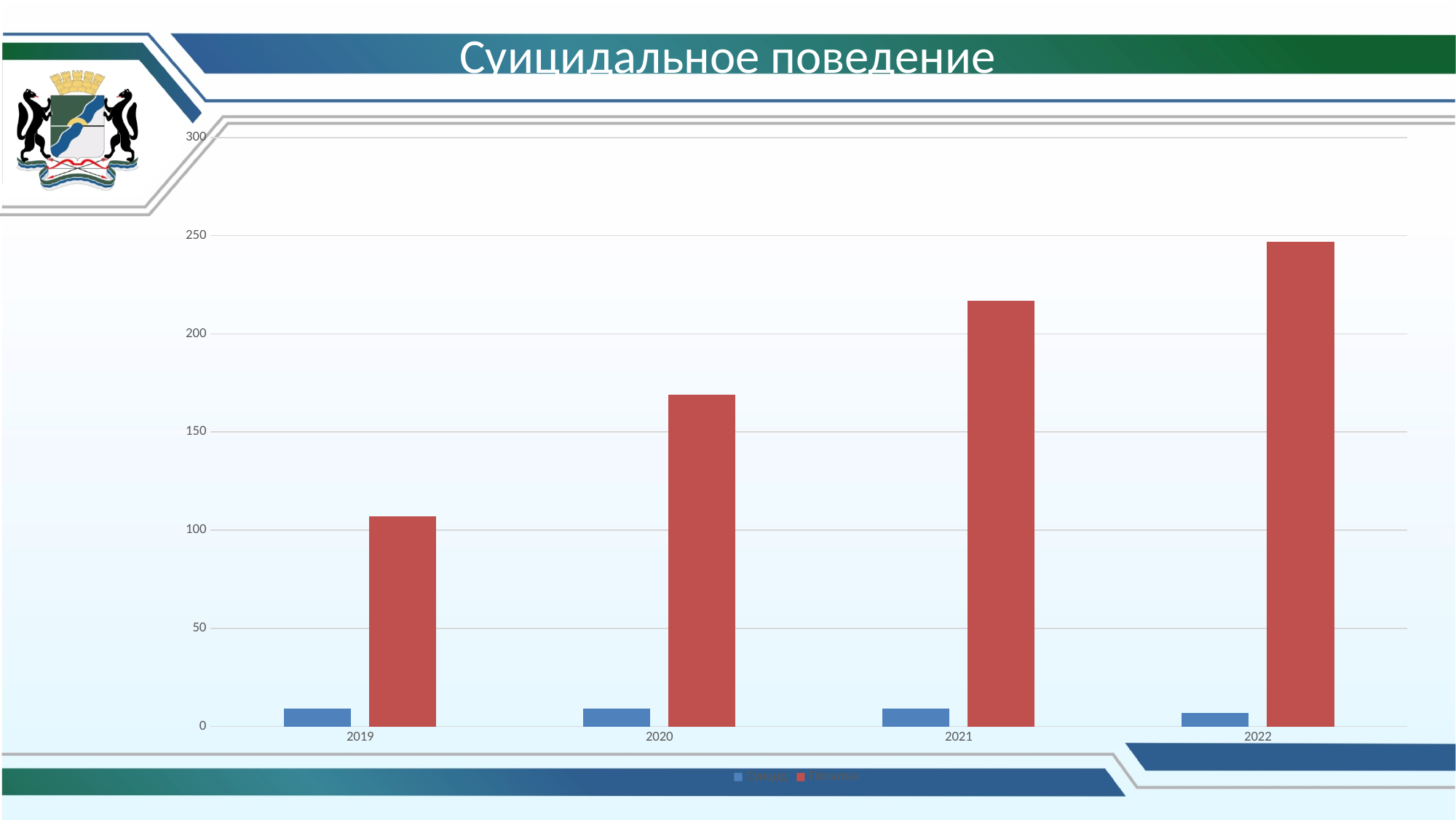
How many years are shown on the x axis of the chart? 4 Is the value of the red bar for 2021 greater or less than 200? greater Is the value of the red bar for 2019 greater or less than 100? greater Do the red bars rise or fall from 2019 to 2022? rise Is the value of the red bar for 2020 greater or less than 200? less In 2020, which bar is larger, the red bar or the blue bar? the red bar How many series does the chart's legend list? 2 In which year is the red bar the highest? 2022 What kind of chart is shown on the slide? bar chart In which year is the red bar the lowest? 2019 What is the title of the chart? Суицидальное поведение